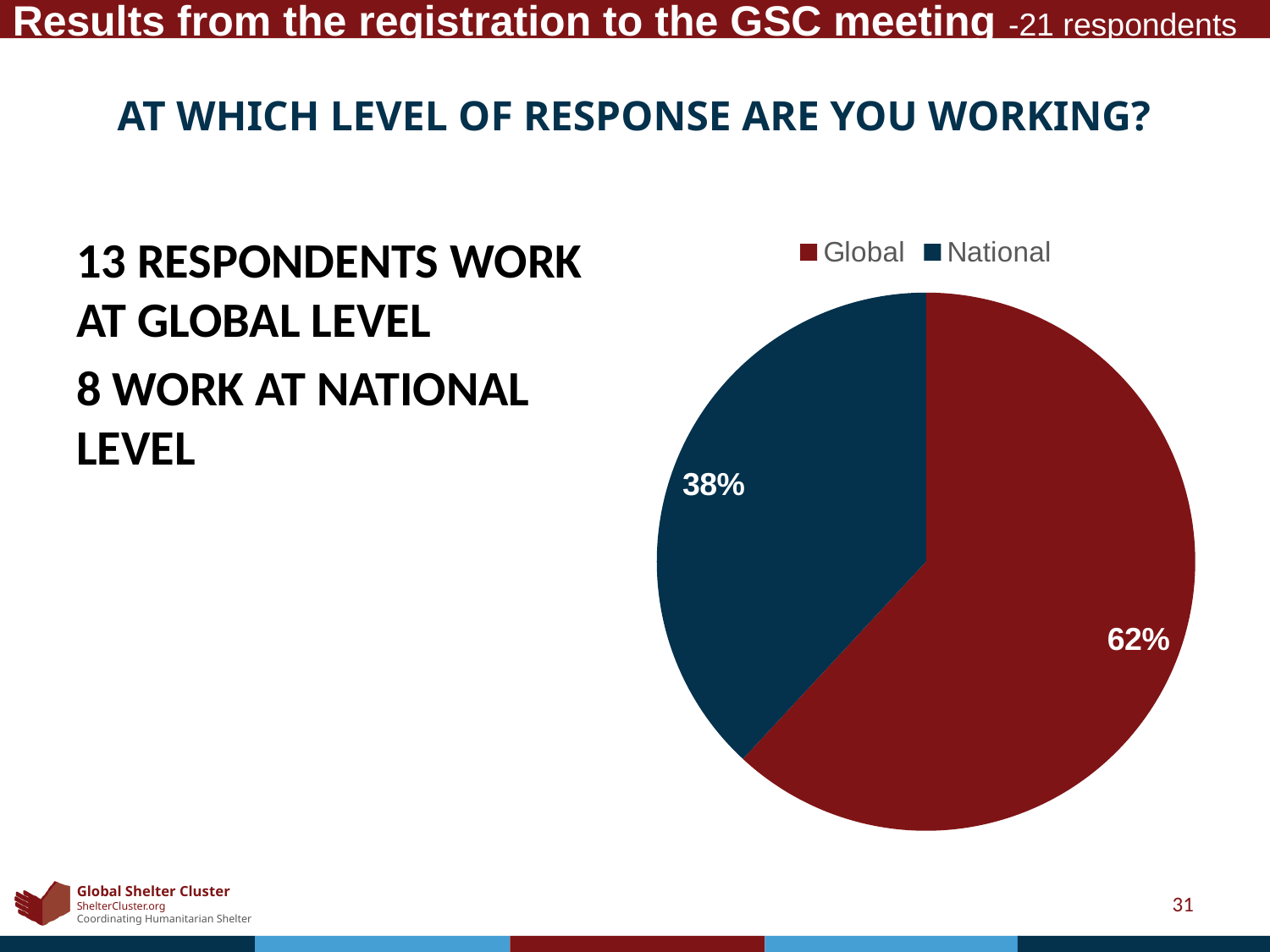
What share of the pie does the Global slice represent? 62% How many slices does the pie chart have? 2 Which is larger, the Global slice or the National slice? Global What colour is the Global slice in the pie chart? dark red How many entries does the legend list? 2 What colour is the National slice in the pie chart? dark blue What is the difference in percentage points between the Global and National slices? 24 percentage points What kind of chart is shown on the slide? pie chart Which slice of the pie is the largest? Global What share of the pie does the National slice represent? 38% Which slice of the pie is the smallest? National